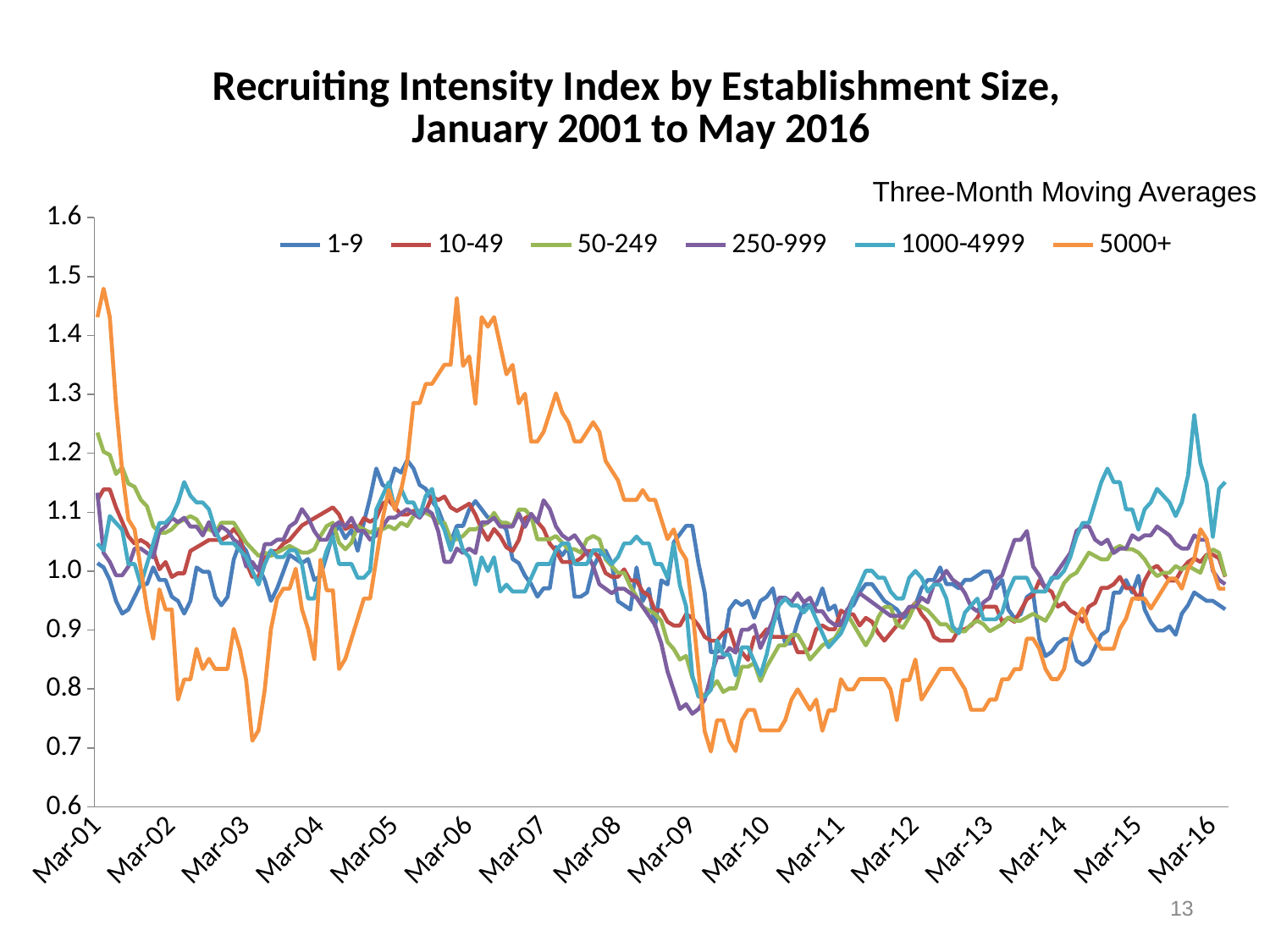
Is the value of the 5000+ series around Mar-10 greater or less than 0.8? less Does the 5000+ series rise or fall between Mar-06 and Mar-10? fall How many labelled tick marks are on the x axis? 16 Around Mar-10, which series is higher: 5000+ or 1-9? 1-9 Is the peak value of the 1000-4999 series shortly before Mar-16 greater or less than 1.2? greater Which series reaches the highest value anywhere on the chart? 5000+ What note appears above the chart's top-right corner describing how the data are smoothed? Three-Month Moving Averages How many series does the legend list? 6 Is the peak value of the 5000+ series around Mar-06 greater or less than 1.4? greater What is the title of the chart? Recruiting Intensity Index by Establishment Size, January 2001 to May 2016 Which series reaches the lowest value anywhere on the chart? 5000+ What kind of chart is shown on the slide? line chart